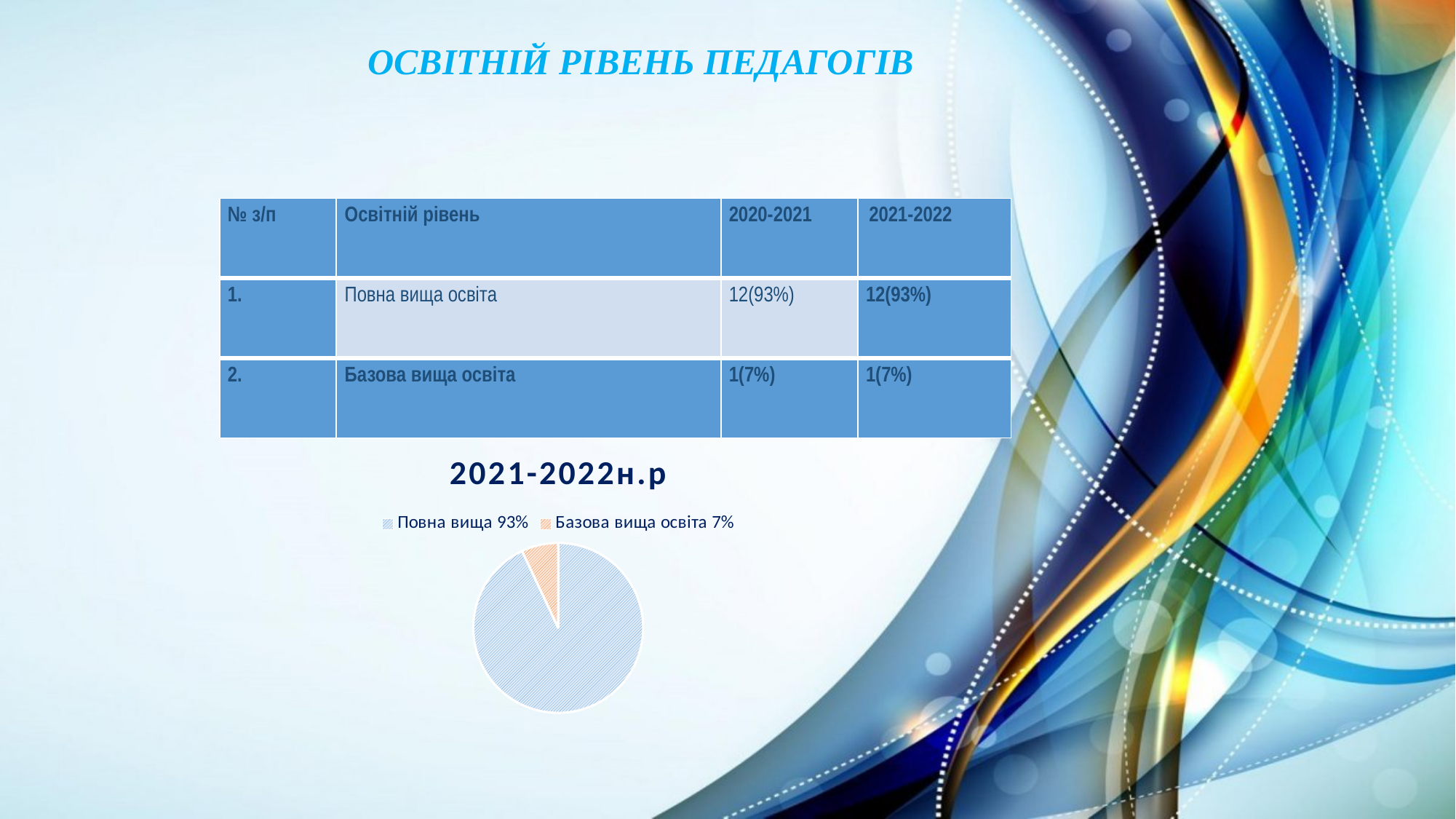
Which slice of the pie chart is the largest? Повна вища What is the title of the pie chart? 2021-2022н.р How many slices does the pie chart have? 2 Which is larger in the pie chart: "Повна вища" or "Базова вища освіта"? Повна вища What is the difference in percentage points between the "Повна вища" and "Базова вища освіта" slices? 86 How many entries does the pie chart's legend list? 2 What kind of chart is shown on the slide? pie chart What share of the pie does "Повна вища" represent? 93% Which slice of the pie chart is the smallest? Базова вища освіта What share of the pie does "Базова вища освіта" represent? 7% What colour is the "Базова вища освіта" slice in the pie chart? orange